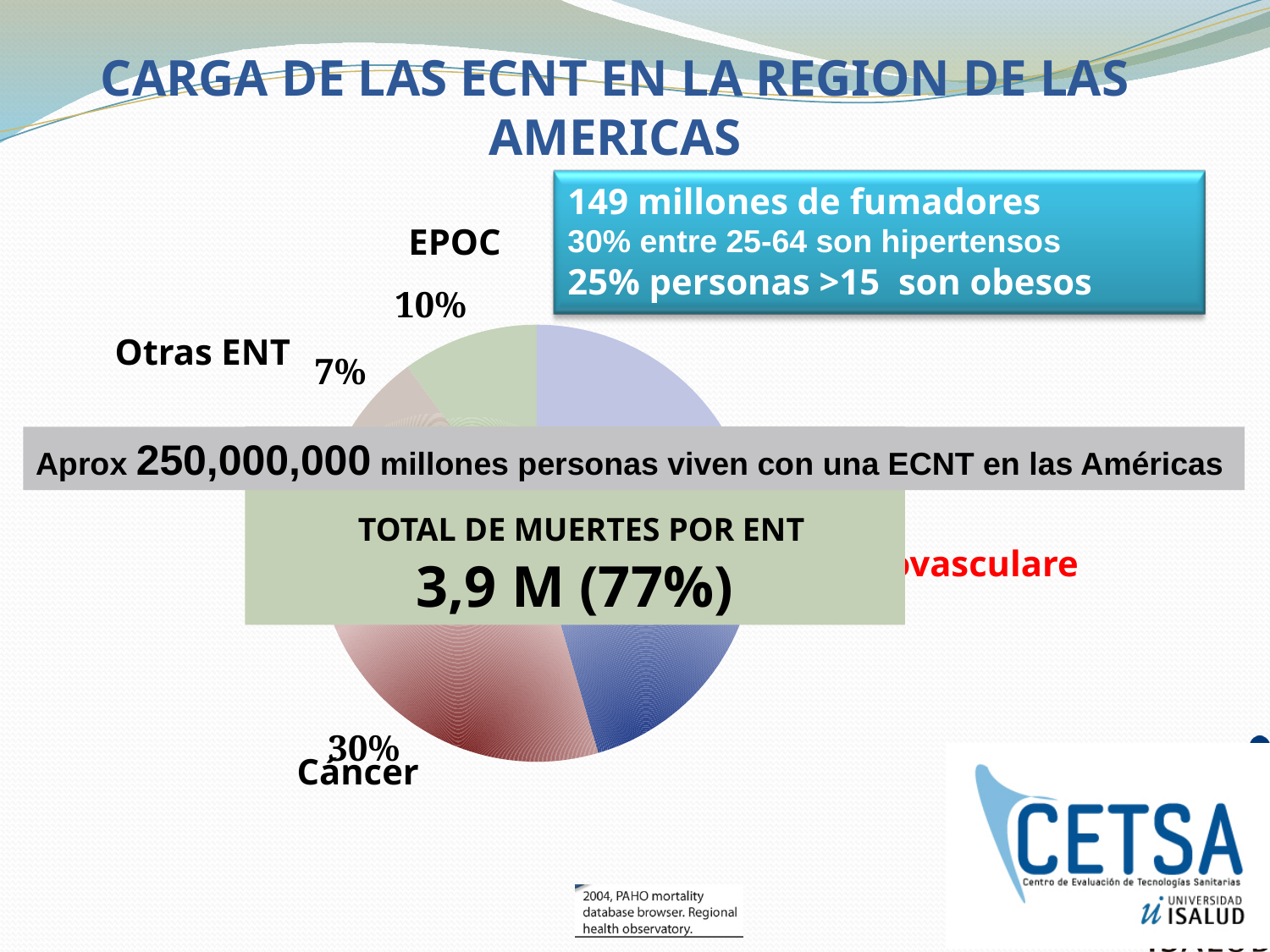
Which has the larger share, Cáncer or EPOC? Cáncer What share of the pie is labelled for EPOC? 10% What kind of chart is shown on the slide? pie chart How many percentage points larger is the Cáncer share than the EPOC share? 20 percentage points Of the slices labelled EPOC, Otras ENT and Cáncer, which has the smallest share? Otras ENT Which has the larger share, EPOC or Otras ENT? EPOC According to the box overlaying the chart, what is the total number of deaths from ENT? 3,9 M (77%) What share of the pie is labelled for Cáncer? 30% What is the title of the slide containing the pie chart? CARGA DE LAS ECNT EN LA REGION DE LAS AMERICAS How many percentage points larger is the EPOC share than the Otras ENT share? 3 percentage points What share of the pie is labelled for Otras ENT? 7%